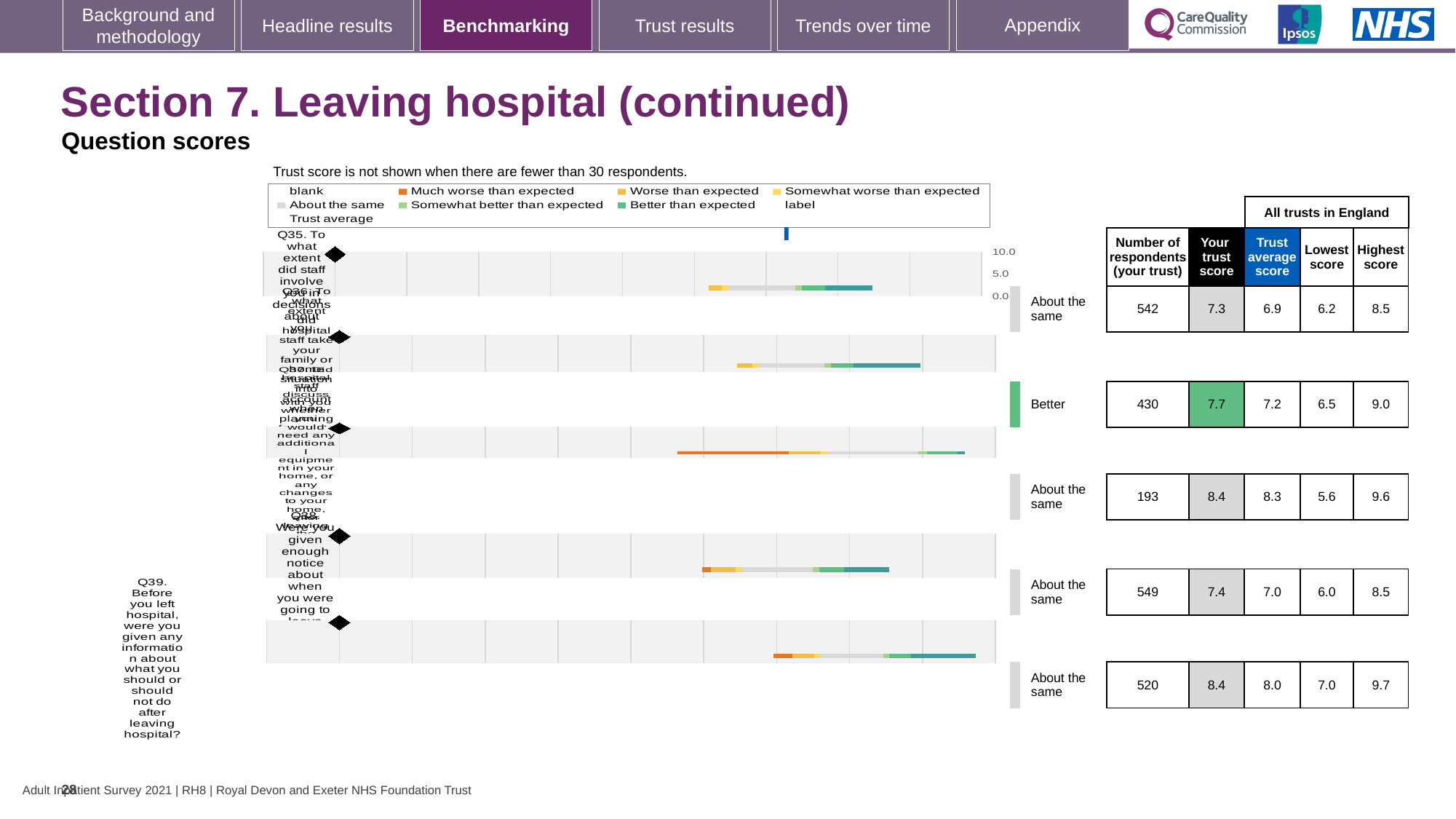
How many question rows are shown in the benchmarking table on this slide? 5 What is the number of respondents (your trust) for the fourth question row? 549 Which question row has the highest 'Highest score' value in the table? the fifth (last) row, 9.7 In the table, what is your trust score for the second question row, the one rated 'Better'? 7.7 What is the difference between your trust score and the trust average score for the second question row? 0.5 According to the note above the chart, when is the trust score not shown? when there are fewer than 30 respondents What kind of chart is used to show the question scores on this slide? bar chart How many question rows are rated 'About the same' in the benchmarking chart? 4 Which question row has the lowest 'Lowest score' value in the table? the third row, 5.6 For the third question row, which is larger: your trust score or the trust average score? your trust score (8.4) In the table, what is the number of respondents (your trust) for the first question row? 542 In the table, what is the trust average score for the second question row? 7.2